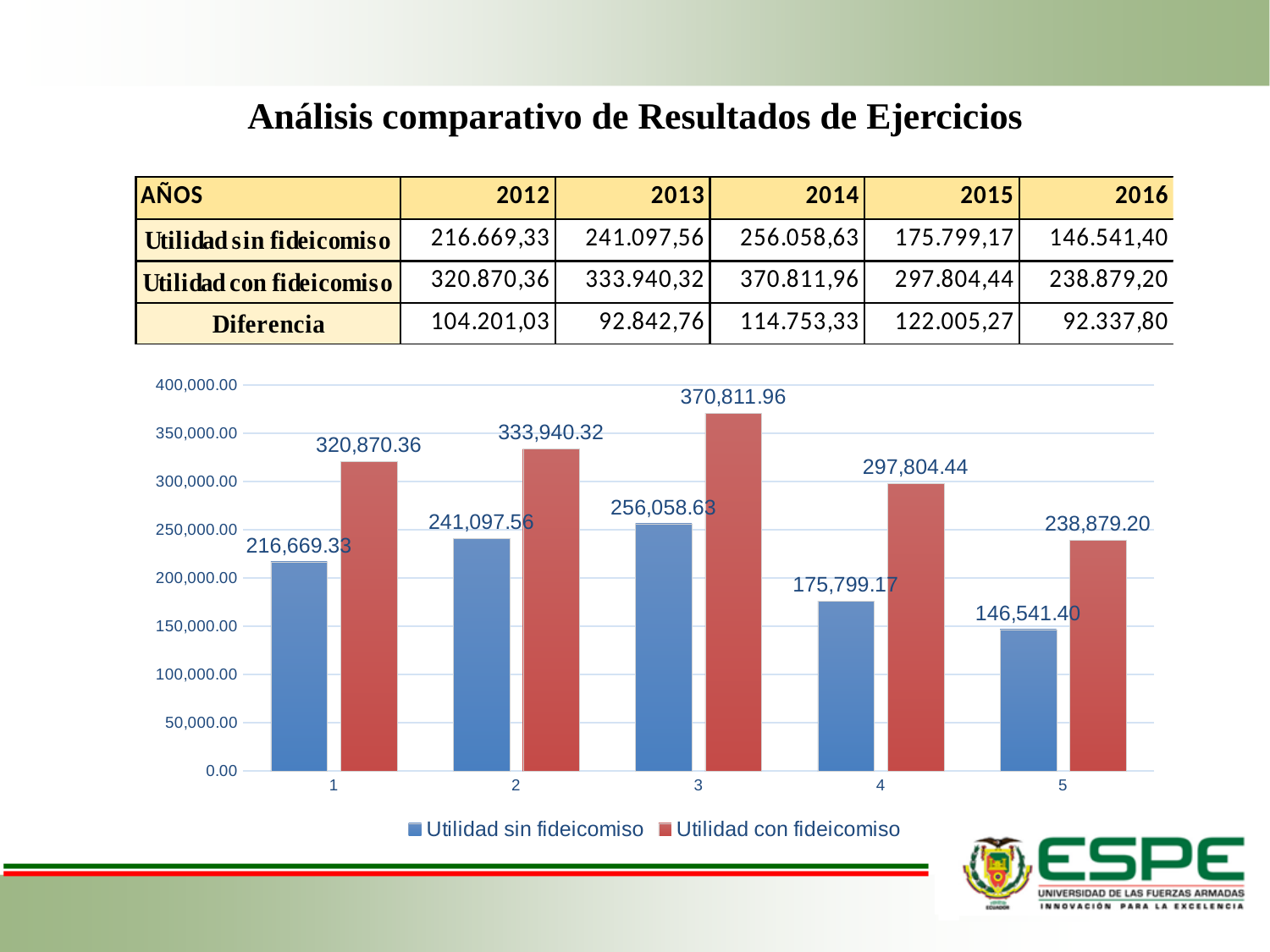
Which colour represents Utilidad con fideicomiso in the chart? Red What is the difference between Utilidad con fideicomiso and Utilidad sin fideicomiso for category 3? 114,753.33 What is the value of Utilidad sin fideicomiso for category 5? 146,541.40 How many series does the chart legend list? 2 What is the value of Utilidad con fideicomiso for category 3? 370,811.96 How many categories are shown on the x axis of the chart? 5 What kind of chart is shown on the slide? Bar chart What is the difference between Utilidad con fideicomiso and Utilidad sin fideicomiso for category 1? 104,201.03 What is the value of Utilidad sin fideicomiso for category 2? 241,097.56 Which category has the lowest value for Utilidad sin fideicomiso? 5 Which category has the highest value for Utilidad con fideicomiso? 3 Which is larger: Utilidad sin fideicomiso for category 3 or Utilidad con fideicomiso for category 5? Utilidad sin fideicomiso for category 3